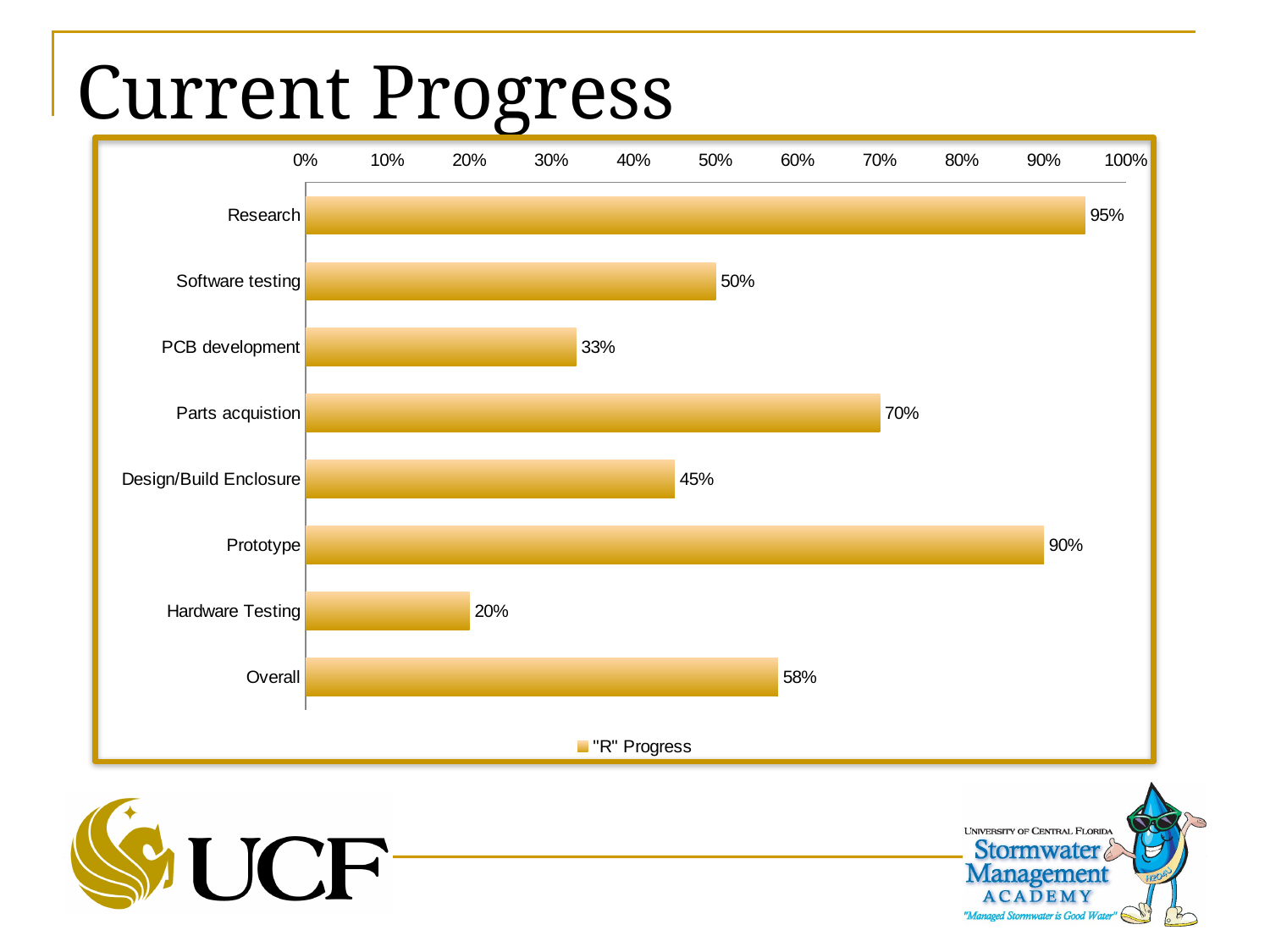
How many categories are shown on the chart? 8 What is the progress value for PCB development? 33% Which has a higher progress value, Software testing or Prototype? Prototype What is the Overall progress value? 58% What series name is listed in the chart legend? "R" Progress What is the difference between the progress values for Parts acquistion and Design/Build Enclosure? 25% Is the value for Design/Build Enclosure greater or less than 50%? less Which category has the lowest progress value? Hardware Testing What is the progress value for Research? 95% What is the progress value for Hardware Testing? 20% Which category has the highest progress value? Research What kind of chart is shown on the slide? bar chart